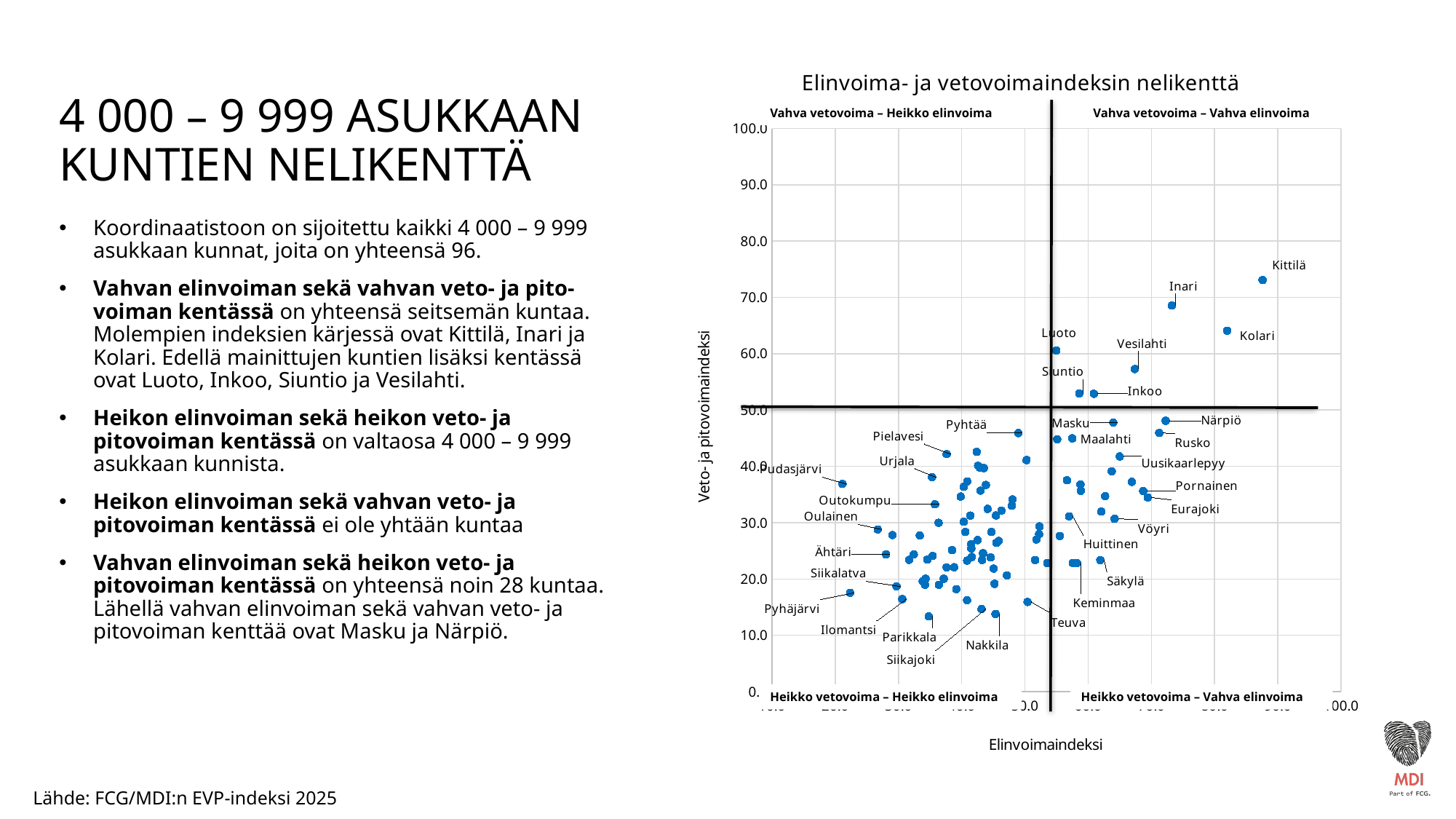
Is the Veto- ja pitovoimaindeksi value for Inari greater or less than 70? less Which has a higher Veto- ja pitovoimaindeksi value, Inari or Kolari? Inari What kind of chart is shown on the slide? scatter chart Which has a higher Veto- ja pitovoimaindeksi value, Vesilahti or Inkoo? Vesilahti How many municipalities are plotted in the chart according to the slide? 96 Is the Veto- ja pitovoimaindeksi value for Kolari greater or less than 60? greater What is the title of the chart? Elinvoima- ja vetovoimaindeksin nelikenttä What is the label of the vertical axis of the chart? Veto- ja pitovoimaindeksi Is the Veto- ja pitovoimaindeksi value for Ilomantsi greater or less than 20? less Which labelled municipality has the highest Veto- ja pitovoimaindeksi value in the chart? Kittilä